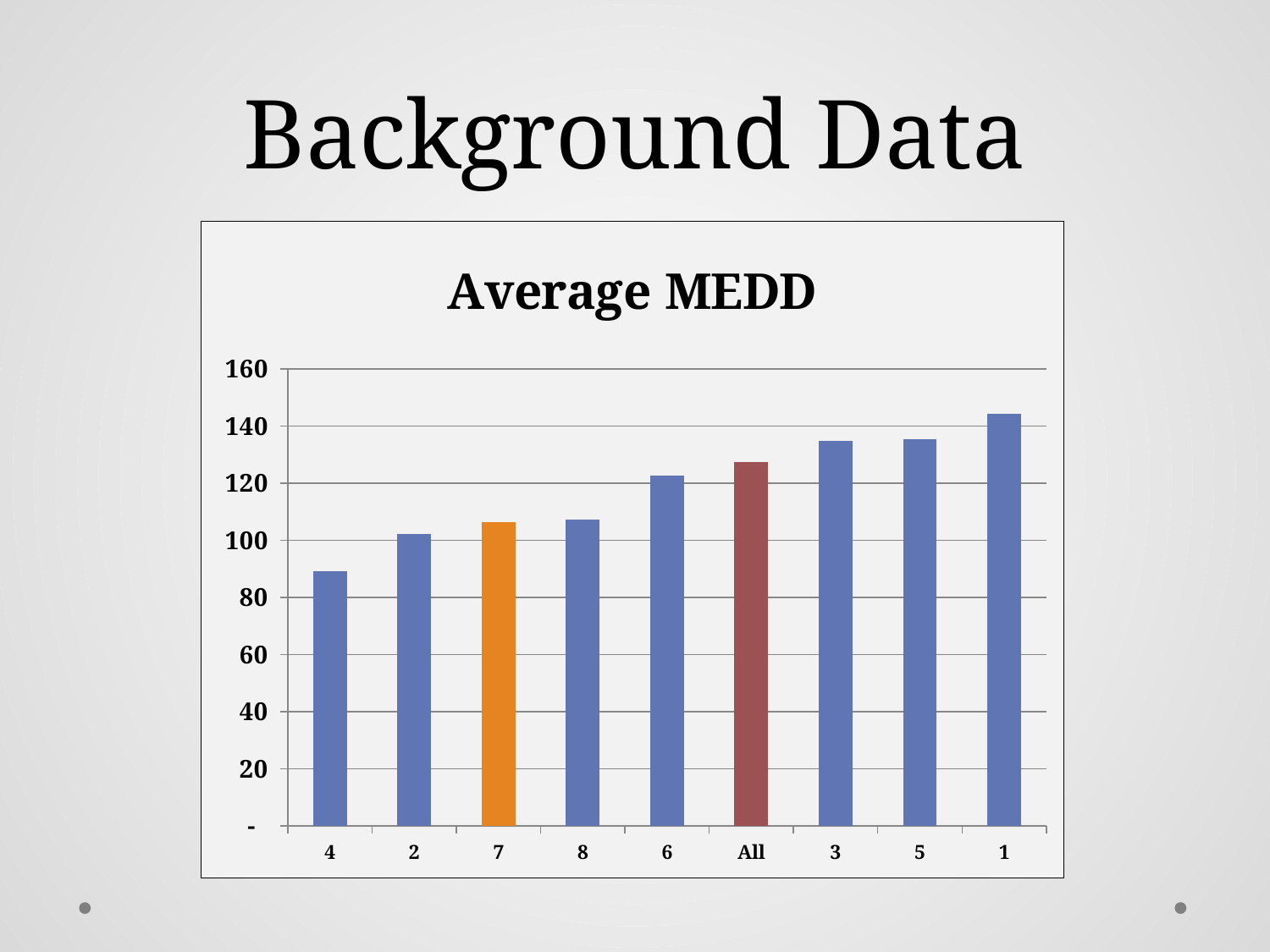
Is the value for All greater or less than 120? greater Is the value for category 4 greater or less than 100? less Which category has the lowest Average MEDD? 4 Is the value for category 7 greater or less than 100? greater What colour is the bar for category 7? orange How many categories are shown on the x axis of the chart? 9 Which category has the highest Average MEDD? 1 What is the title of the chart? Average MEDD Which has a larger Average MEDD, category 1 or category 4? 1 Do the values generally rise or fall moving from left to right along the x axis? rise What kind of chart is shown on the slide? bar chart